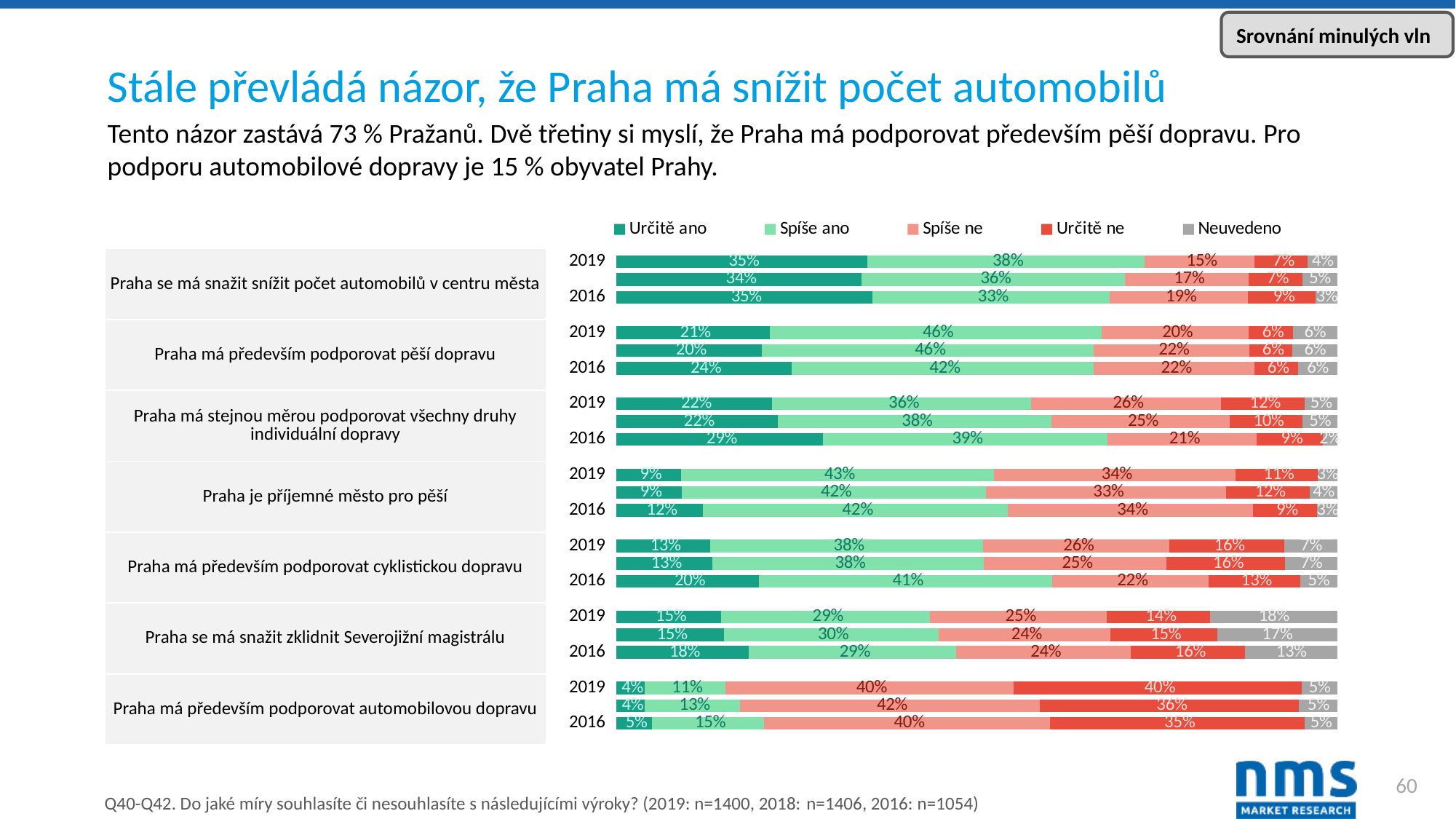
Which statement has the highest "Určitě ano" value in 2019? Praha se má snažit snížit počet automobilů v centru města What is the 2019 value of "Spíše ano" for "Praha má především podporovat pěší dopravu"? 46% What is the 2019 value of "Určitě ne" for "Praha má především podporovat automobilovou dopravu"? 40% What is the 2019 value of "Určitě ano" for "Praha se má snažit snížit počet automobilů v centru města"? 35% By how many percentage points did "Určitě ano" for "Praha má především podporovat cyklistickou dopravu" fall from 2016 to 2019? 7 percentage points For "Praha je příjemné město pro pěší" in 2019, which is larger: "Spíše ne" or "Určitě ne"? Spíše ne How many series does the chart legend list? 5 What kind of chart is shown on the slide? Stacked bar chart What is the 2016 value of "Spíše ne" for "Praha má stejnou měrou podporovat všechny druhy individuální dopravy"? 21% What is the 2019 value of "Neuvedeno" for "Praha se má snažit zklidnit Severojižní magistrálu"? 18% What is the combined share of "Určitě ano" and "Spíše ano" for "Praha se má snažit snížit počet automobilů v centru města" in 2019? 73% How many statements (categories) are shown in the chart? 7